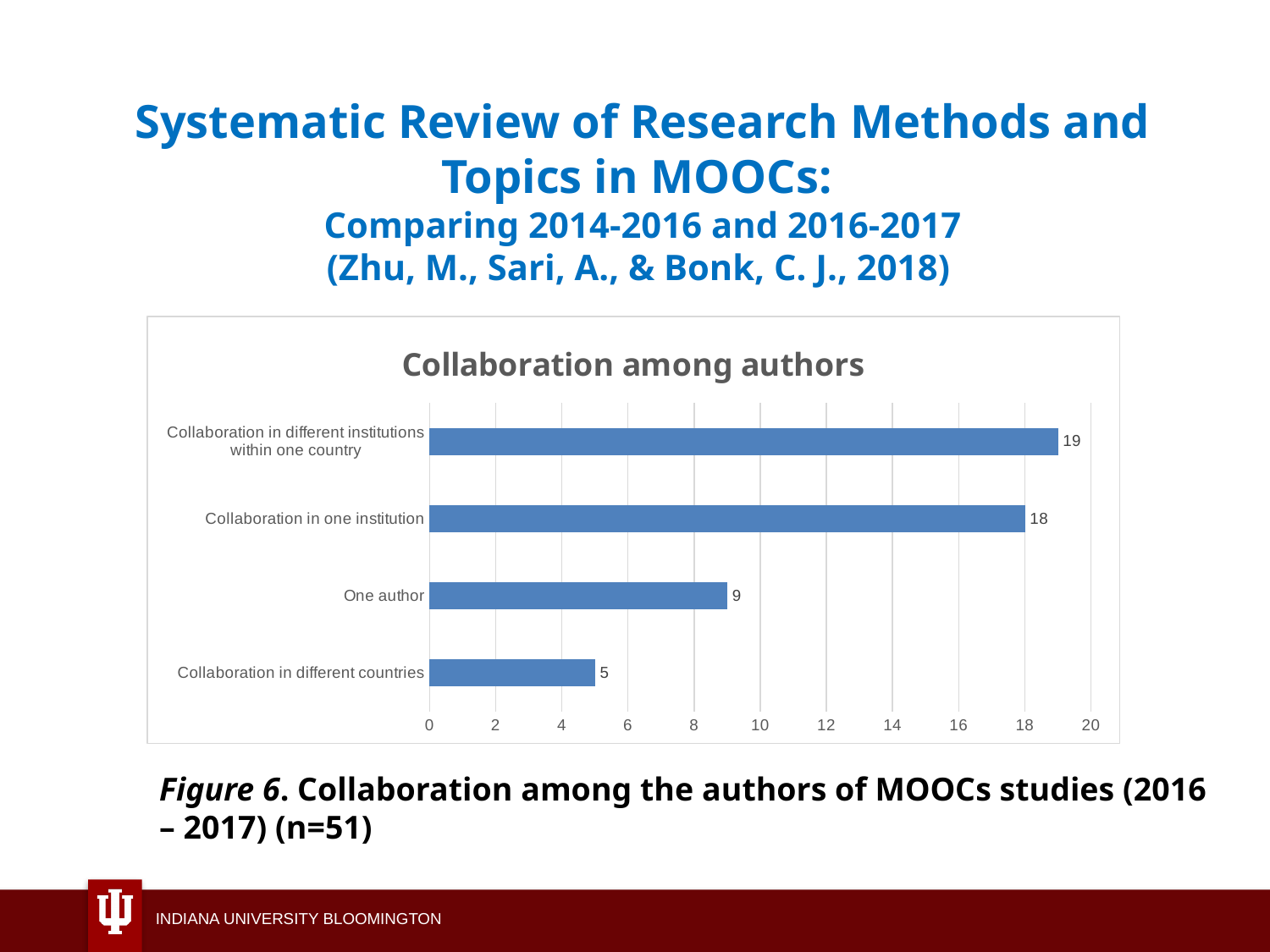
What is the value for "Collaboration in different countries"? 5 How many categories are shown in the chart? 4 What is the value for "Collaboration in one institution"? 18 What is the difference between the values for "Collaboration in different institutions within one country" and "Collaboration in one institution"? 1 Which is larger: the value for "One author" or the value for "Collaboration in different countries"? One author What is the value for "Collaboration in different institutions within one country"? 19 What is the value for "One author"? 9 What is the difference between the values for "One author" and "Collaboration in different countries"? 4 Which category has the highest value? Collaboration in different institutions within one country What is the title of the chart? Collaboration among authors What kind of chart is shown on the slide? Bar chart Which category has the lowest value? Collaboration in different countries